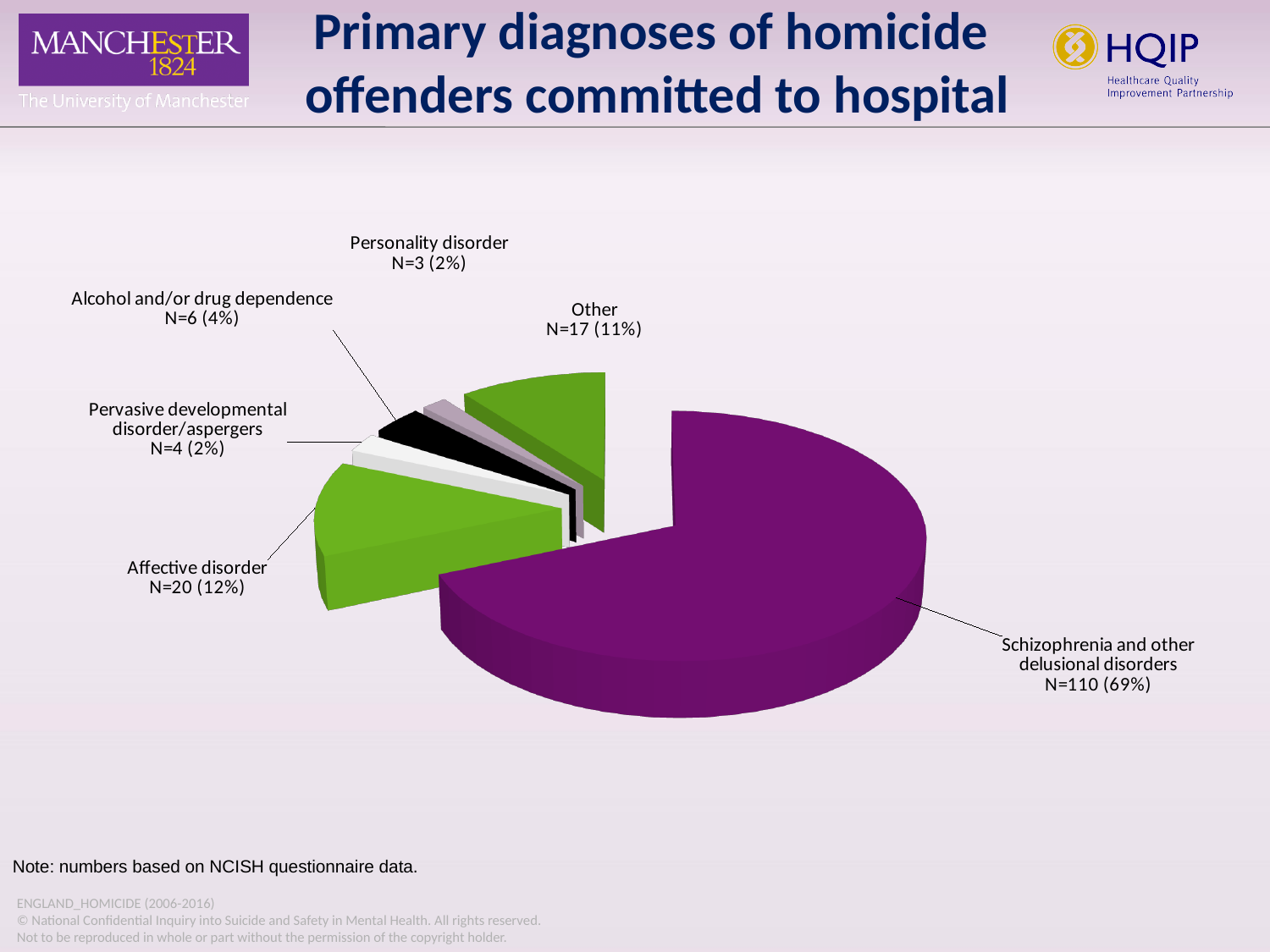
What is the difference in the number of offenders between Affective disorder and Other? 3 How many offenders had a primary diagnosis of Other? 17 Which has more offenders: Alcohol and/or drug dependence or Pervasive developmental disorder/aspergers? Alcohol and/or drug dependence Which primary diagnosis category has the smallest number of offenders? Personality disorder What is the N value for Affective disorder? N=20 (12%) Which primary diagnosis category has the largest slice of the pie? Schizophrenia and other delusional disorders What kind of chart is shown on the slide? Pie chart What percentage of homicide offenders committed to hospital had a primary diagnosis of Schizophrenia and other delusional disorders? 69% What percentage share does Alcohol and/or drug dependence represent? 4% What is the title of the chart on the slide? Primary diagnoses of homicide offenders committed to hospital How many diagnosis categories are shown in the pie chart? 6 What is the N value for Pervasive developmental disorder/aspergers? N=4 (2%)